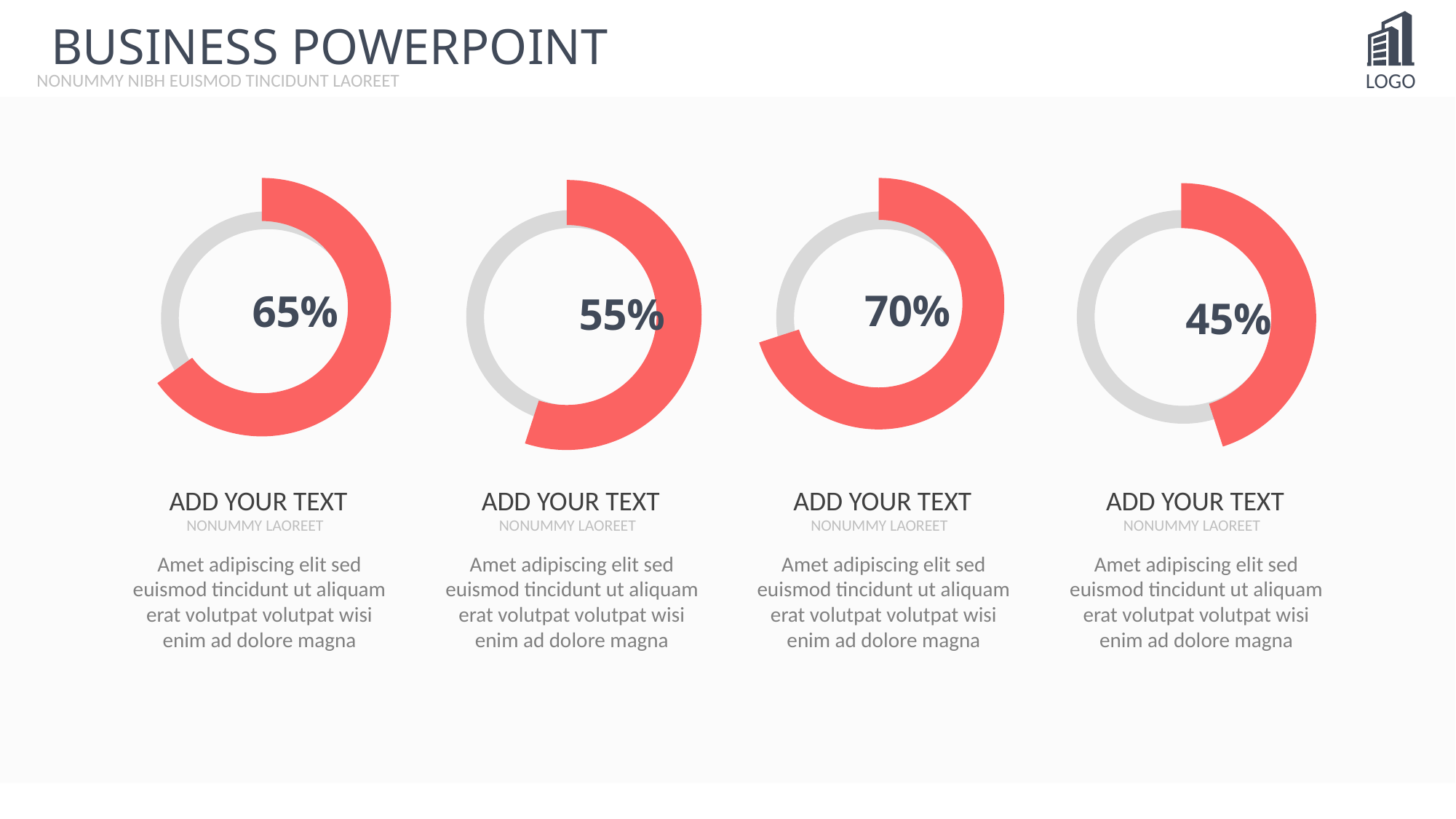
Which of the four donut charts shows the lowest percentage? The rightmost (45%) Which of the four donut charts shows the highest percentage? The third from the left (70%) What is the difference between the percentage in the third donut chart and the percentage in the second donut chart? 15% What percentage is shown in the second donut chart from the left? 55% What percentage is shown in the third donut chart from the left? 70% What percentage is shown in the leftmost donut chart? 65% How many donut charts are shown on the slide? 4 What is the difference between the percentage in the leftmost donut chart and the percentage in the rightmost donut chart? 20% What colour is the filled portion of each donut chart? Red What percentage is shown in the rightmost donut chart? 45% Which is larger: the percentage in the leftmost donut chart or the percentage in the second donut chart? The leftmost (65%) What kind of chart is used to display the percentages on the slide? Donut chart